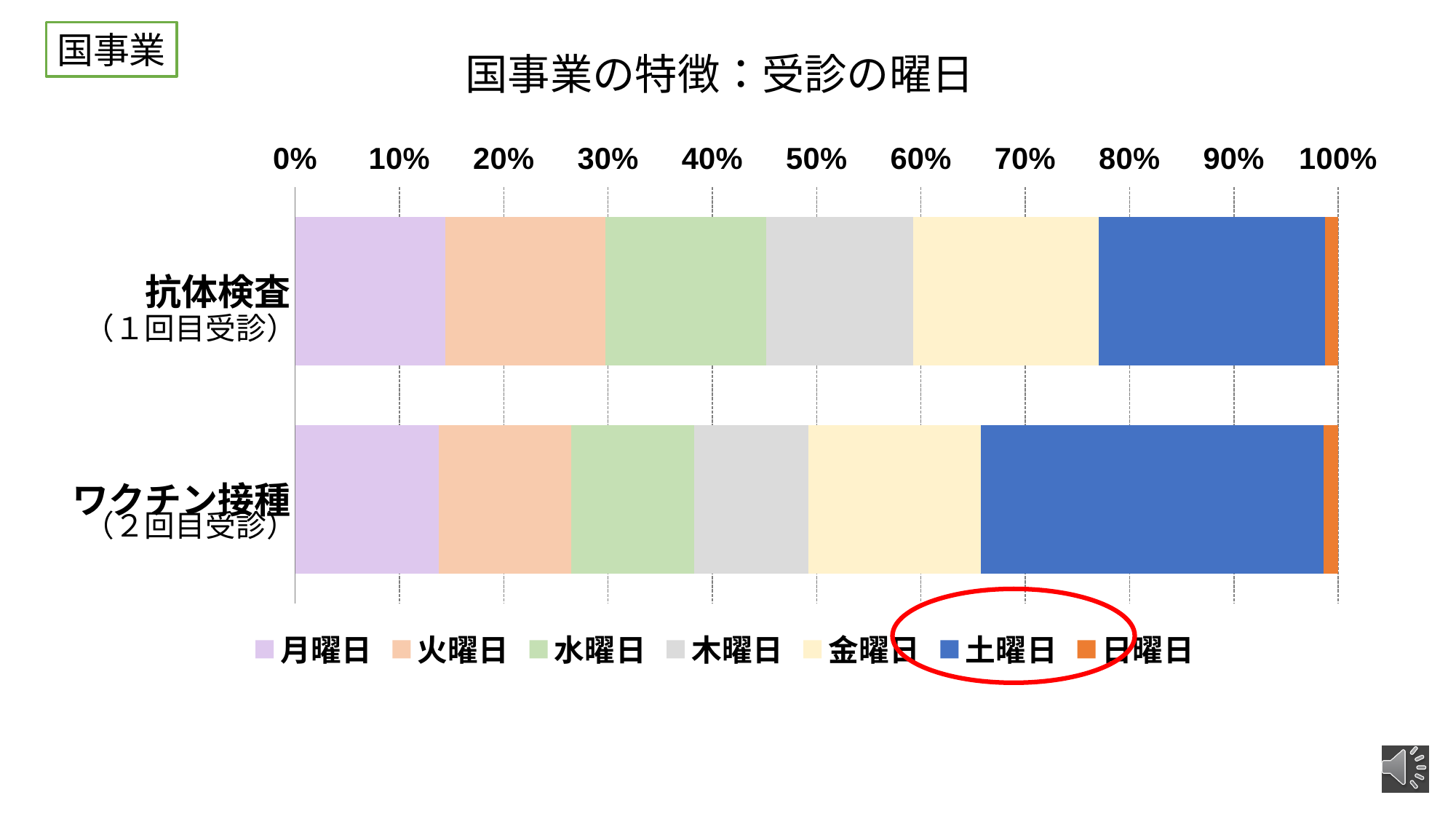
What kind of chart is shown on the slide? Stacked bar chart What is the title of the chart? 国事業の特徴：受診の曜日 Is the 月曜日 share for 抗体検査（1回目受診） greater or less than 20%? less Which day of the week has the largest share in the ワクチン接種（2回目受診） bar? 土曜日 Is the 日曜日 share for ワクチン接種（2回目受診） greater or less than 10%? less Which day of the week has the smallest share in the 抗体検査（1回目受診） bar? 日曜日 Is the 土曜日 share for ワクチン接種（2回目受診） greater or less than 20%? greater Which legend entry is circled in red? 土曜日 How many series does the legend list? 7 Which day of the week has the largest share in the 抗体検査（1回目受診） bar? 土曜日 Is the 土曜日 share for ワクチン接種（2回目受診） larger or smaller than the 土曜日 share for 抗体検査（1回目受診）? larger How many categories (bars) does the chart show? 2